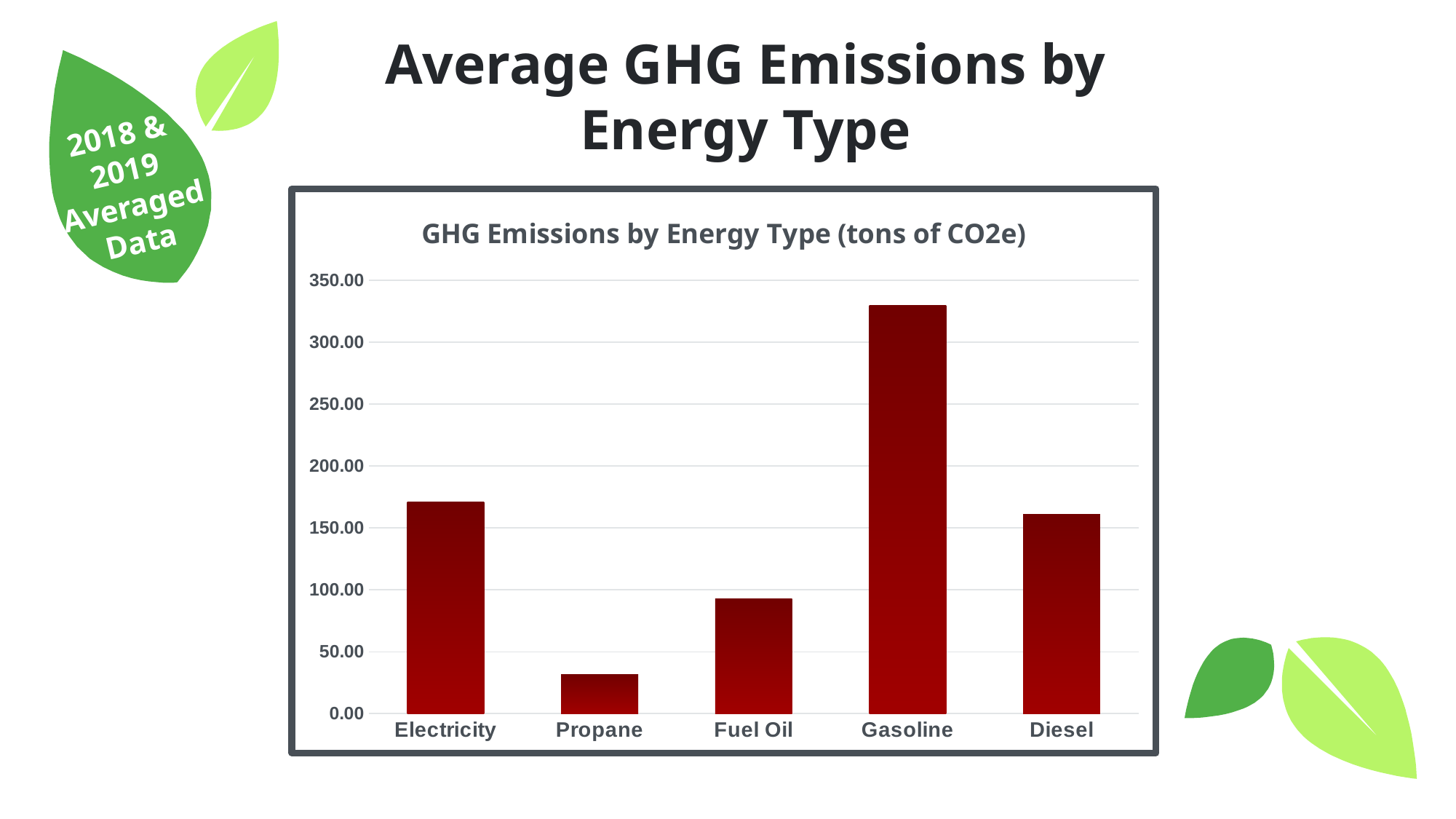
Is the value for Fuel Oil greater or less than 100.00? less Is the value for Propane greater or less than 50.00? less Which energy type has the lowest GHG emissions? Propane Which energy type has the highest GHG emissions? Gasoline Which has higher GHG emissions, Fuel Oil or Propane? Fuel Oil What is the title of the chart? GHG Emissions by Energy Type (tons of CO2e) Is the value for Gasoline greater or less than 300.00? greater What kind of chart is shown on the slide? bar chart How many energy types are shown on the x axis of the chart? 5 Which has higher GHG emissions, Gasoline or Electricity? Gasoline